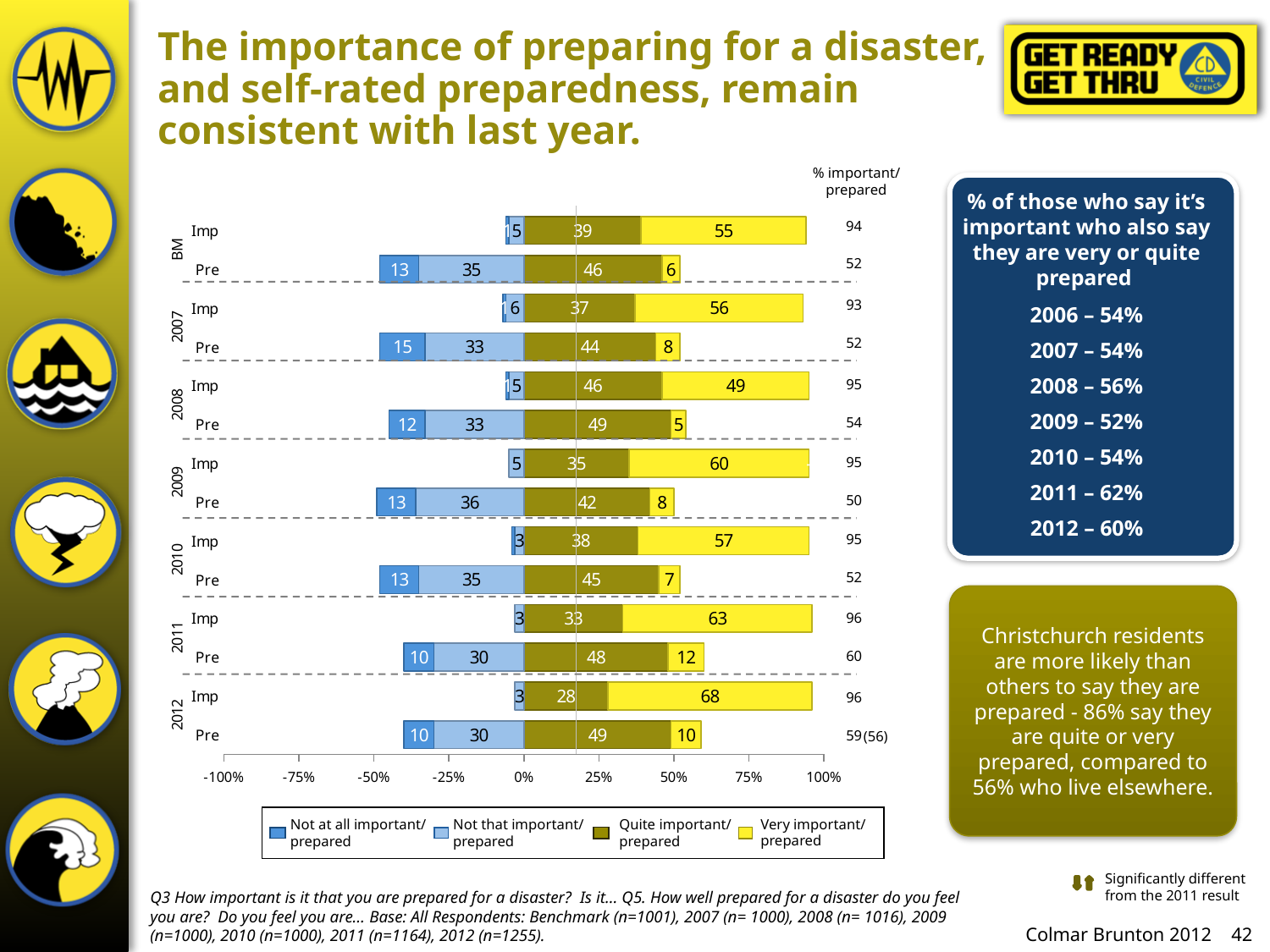
What kind of chart is shown on the slide? Stacked bar chart What is the '% important/prepared' figure shown for the 2011 Imp bar? 96 What is the difference between the 'Very important/prepared' values of the 2012 Imp bar and the BM Imp bar? 13 Which year's Imp bar has the highest 'Very important/prepared' value? 2012 What is the 'Very important/prepared' value for the 2012 Imp bar? 68 Which is larger: the 'Quite important/prepared' value for the 2008 Imp bar or for the 2012 Imp bar? 2008 Imp What is the 'Not that important/prepared' value for the 2011 Pre bar? 30 Does the 'Very important/prepared' value for the Imp bars generally rise or fall from BM to 2012? Rise Which year's Pre bar has the lowest 'Very important/prepared' value? 2008 What is the '% important/prepared' figure shown for the 2012 Pre bar? 59(56) How many series does the legend list? 4 What is the 'Quite important/prepared' value for the 2008 Pre bar? 49